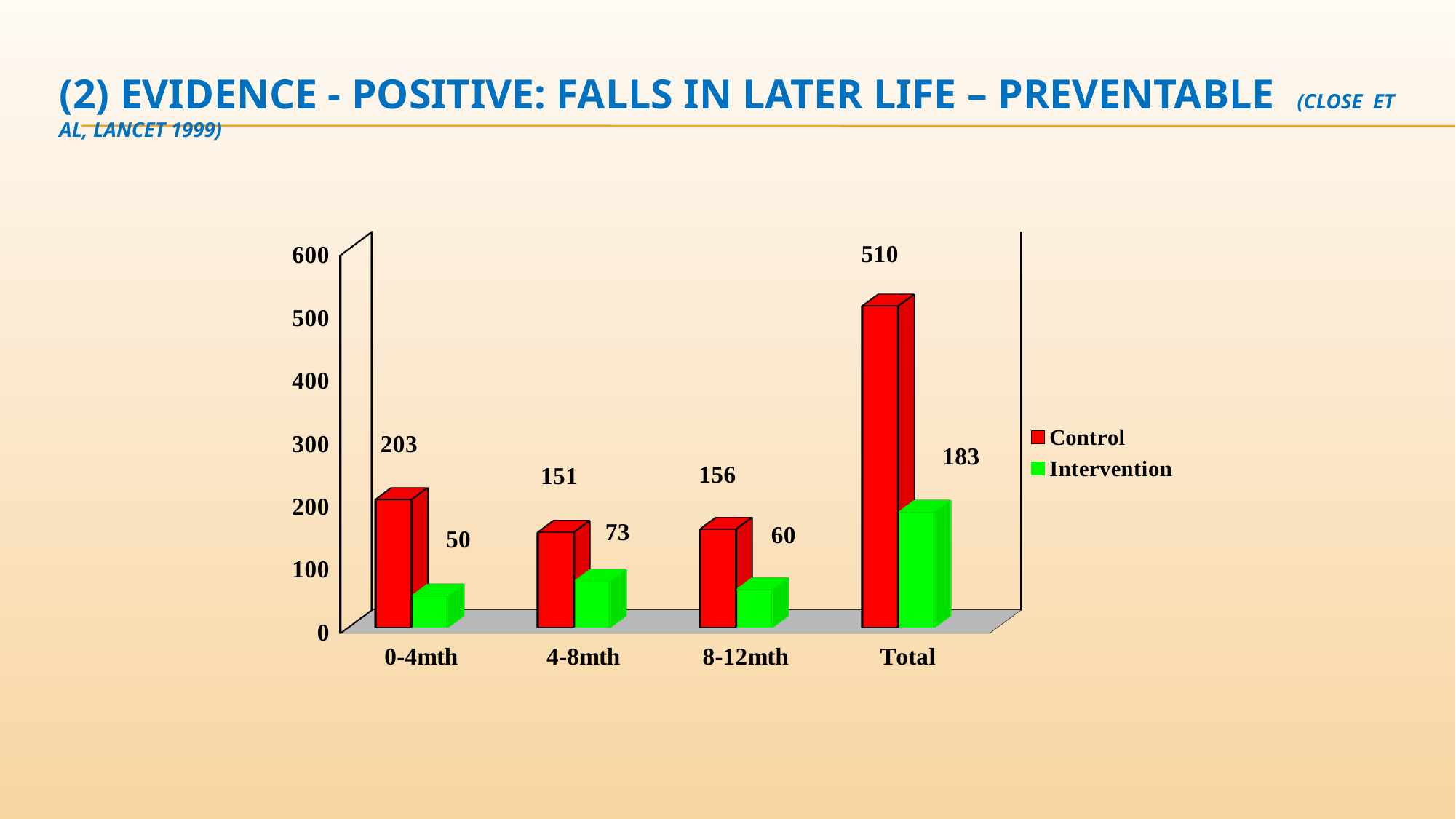
What is the Intervention value for 4-8mth? 73 What kind of chart is shown on the slide? Bar chart What is the Intervention value for 8-12mth? 60 What is the Control value for 0-4mth? 203 How many series does the legend list? 2 Among the three time periods (excluding Total), which has the highest Control value? 0-4mth What is the difference between the Control and Intervention values for Total? 327 Which is larger, the Intervention value for 4-8mth or for 8-12mth? 4-8mth How many categories are shown on the x axis? 4 What is the Control value for Total? 510 What is the difference between the Control values for 8-12mth and 4-8mth? 5 Which category has the lowest Intervention value? 0-4mth